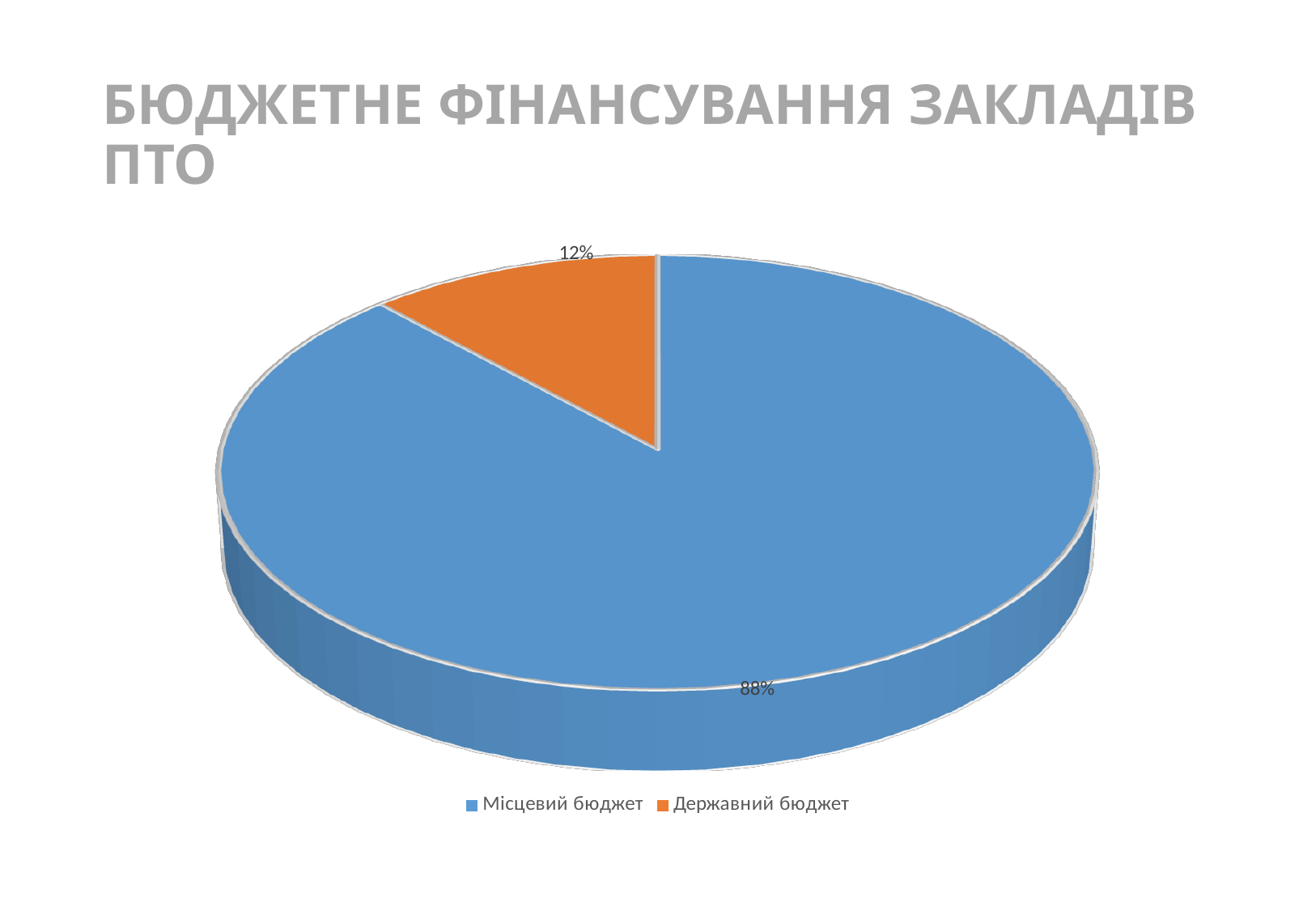
What share of the pie does Державний бюджет account for? 12% Which is larger, the slice for Місцевий бюджет or the slice for Державний бюджет? Місцевий бюджет What is the title of the slide? БЮДЖЕТНЕ ФІНАНСУВАННЯ ЗАКЛАДІВ ПТО How many slices does the pie chart have? 2 What is the difference in percentage points between Місцевий бюджет and Державний бюджет? 76 Which category has the largest slice of the pie? Місцевий бюджет Which category has the smallest slice of the pie? Державний бюджет What colour is the slice for Державний бюджет? Orange What kind of chart is shown on the slide? Pie chart How many entries does the legend list? 2 What share of the pie does Місцевий бюджет account for? 88%